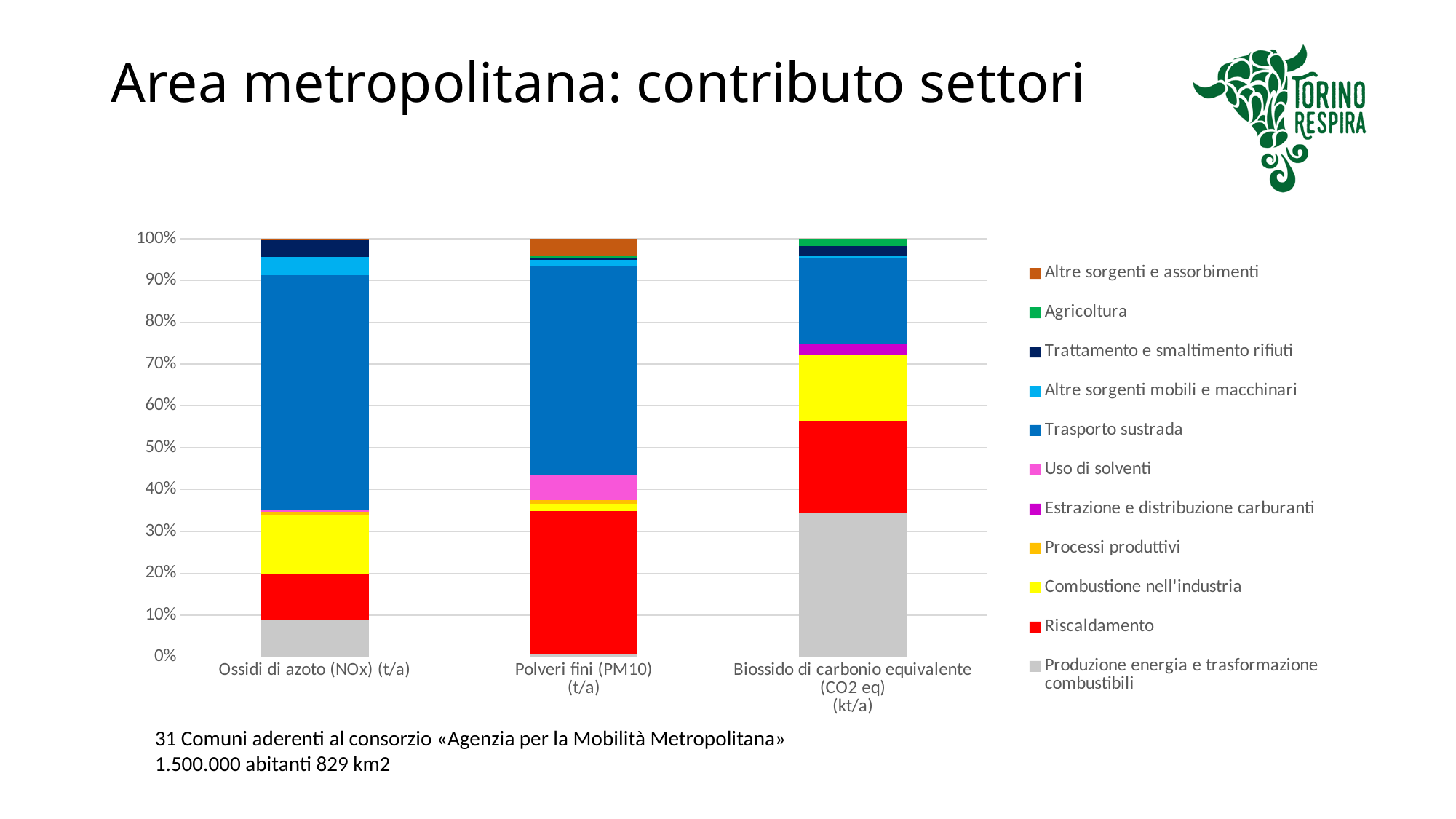
Is the share of Trasporto su strada larger in the Ossidi di azoto (NOx) (t/a) bar or in the Biossido di carbonio equivalente (CO2 eq) (kt/a) bar? Ossidi di azoto (NOx) (t/a) What kind of chart is shown on the slide? stacked bar chart What colour represents Riscaldamento in the chart? red Is the share of Riscaldamento in the Biossido di carbonio equivalente (CO2 eq) (kt/a) bar greater or less than 30%? less Is the share of Riscaldamento in the Polveri fini (PM10) (t/a) bar greater or less than 30%? greater Is the share of Trasporto su strada in the Ossidi di azoto (NOx) (t/a) bar greater or less than 50%? greater Which series is listed first (at the top) in the chart's legend? Altre sorgenti e assorbimenti Is the share of Riscaldamento larger in the Polveri fini (PM10) (t/a) bar or in the Ossidi di azoto (NOx) (t/a) bar? Polveri fini (PM10) (t/a) How many categories are shown on the x axis of the chart? 3 In which category does Produzione energia e trasformazione combustibili have the largest share? Biossido di carbonio equivalente (CO2 eq) (kt/a) How many series does the chart's legend list? 11